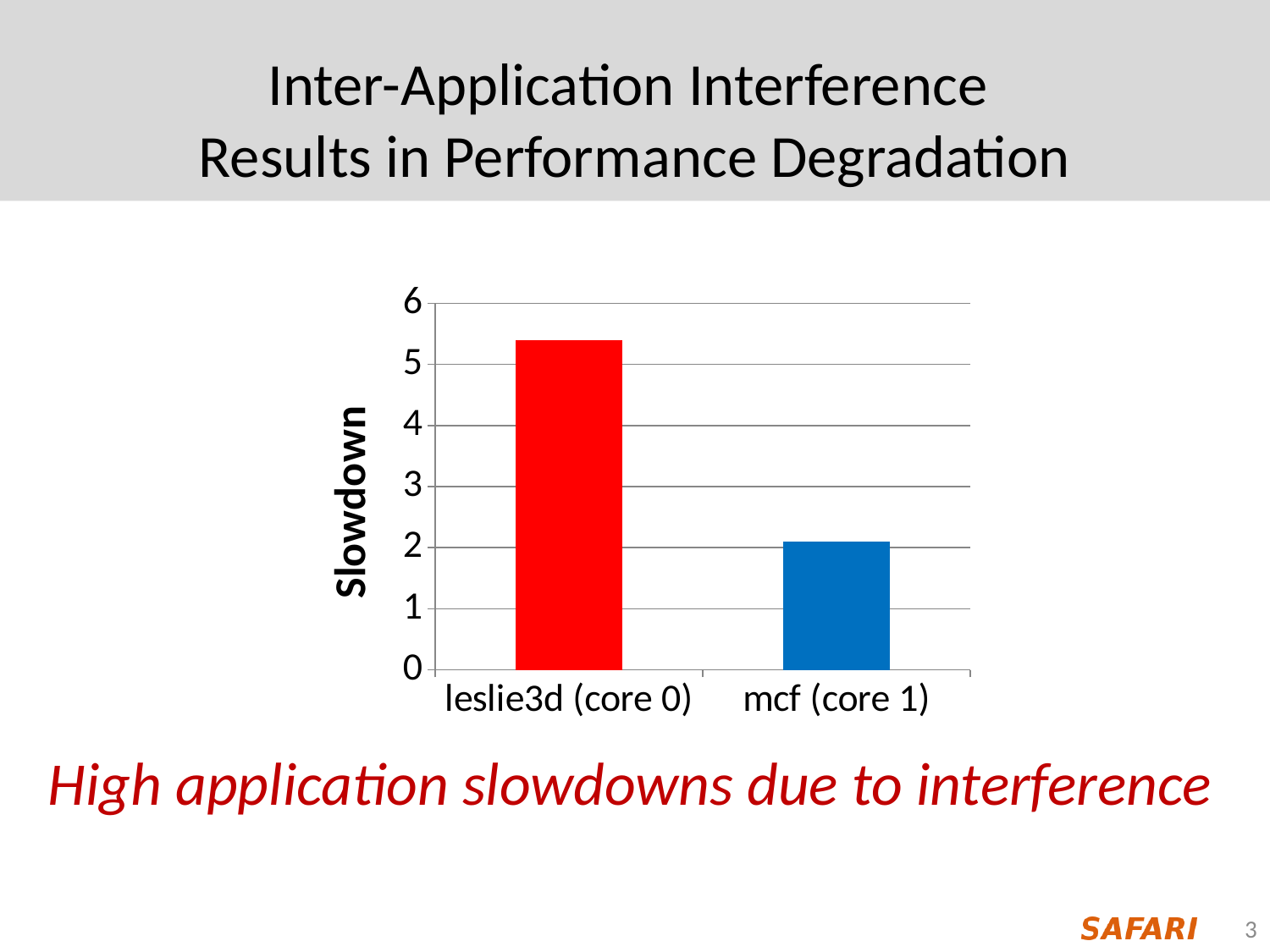
Is the slowdown for mcf (core 1) greater or less than 1? greater Which has a larger slowdown, leslie3d (core 0) or mcf (core 1)? leslie3d (core 0) What colour is the bar for leslie3d (core 0)? red What is the label of the vertical axis? Slowdown Which category has the lowest slowdown? mcf (core 1) Is the slowdown for leslie3d (core 0) greater or less than 5? greater Is the slowdown for leslie3d (core 0) greater or less than 6? less How many categories are plotted in the chart? 2 What kind of chart is shown on the slide? bar chart Which category has the highest slowdown? leslie3d (core 0)